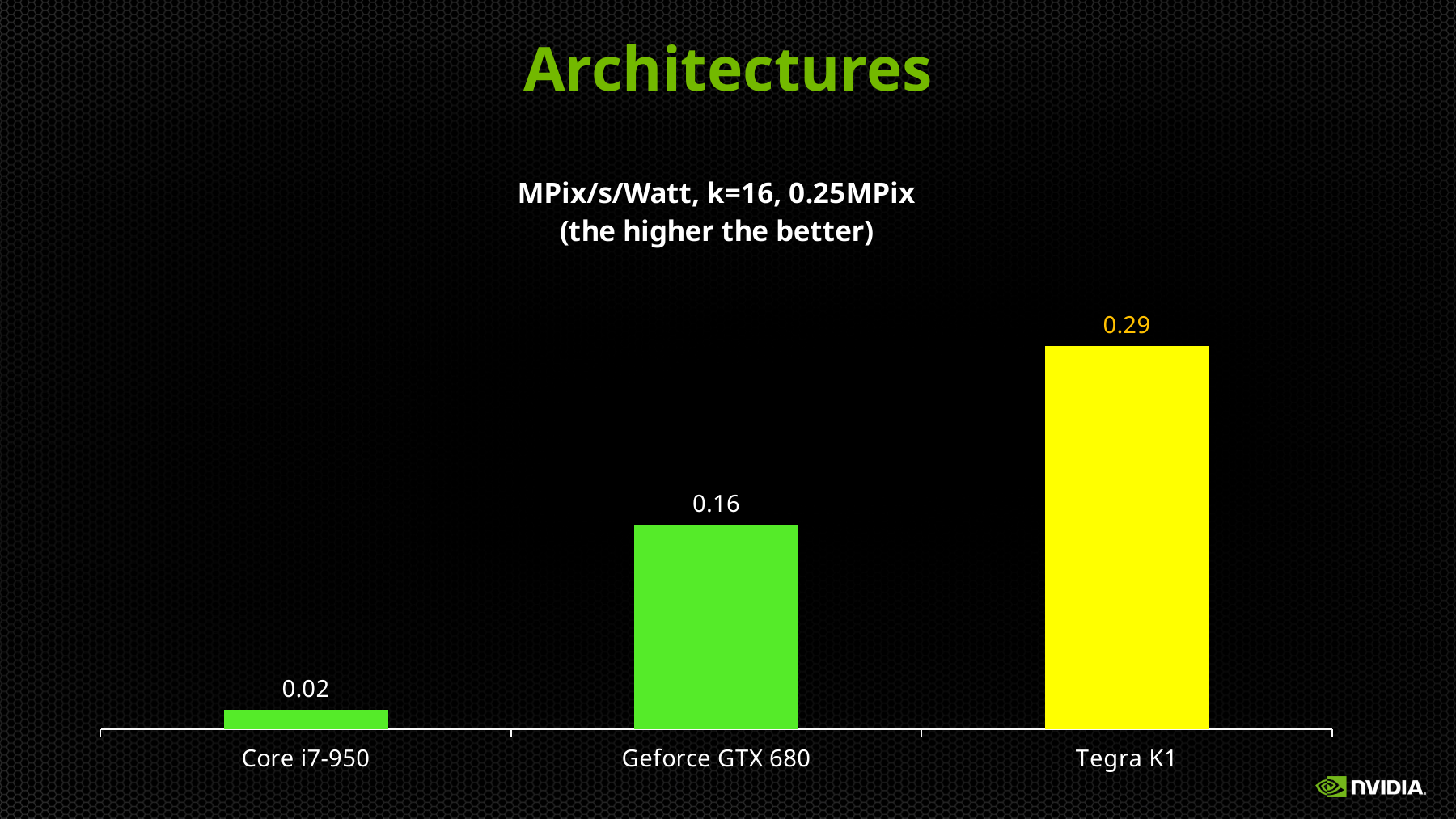
Which architecture has the highest value? Tegra K1 Do the values rise or fall from left to right across the categories? Rise What is the difference between the values for Tegra K1 and Geforce GTX 680? 0.13 How many architectures are shown in the chart? 3 What is the difference between the values for Geforce GTX 680 and Core i7-950? 0.14 What kind of chart is shown on the slide? Bar chart Which architecture has the lowest value? Core i7-950 What is the value for Core i7-950? 0.02 Which has a larger value, Geforce GTX 680 or Core i7-950? Geforce GTX 680 What is the value for Geforce GTX 680? 0.16 What is the title of the chart? MPix/s/Watt, k=16, 0.25MPix (the higher the better) What is the value for Tegra K1? 0.29